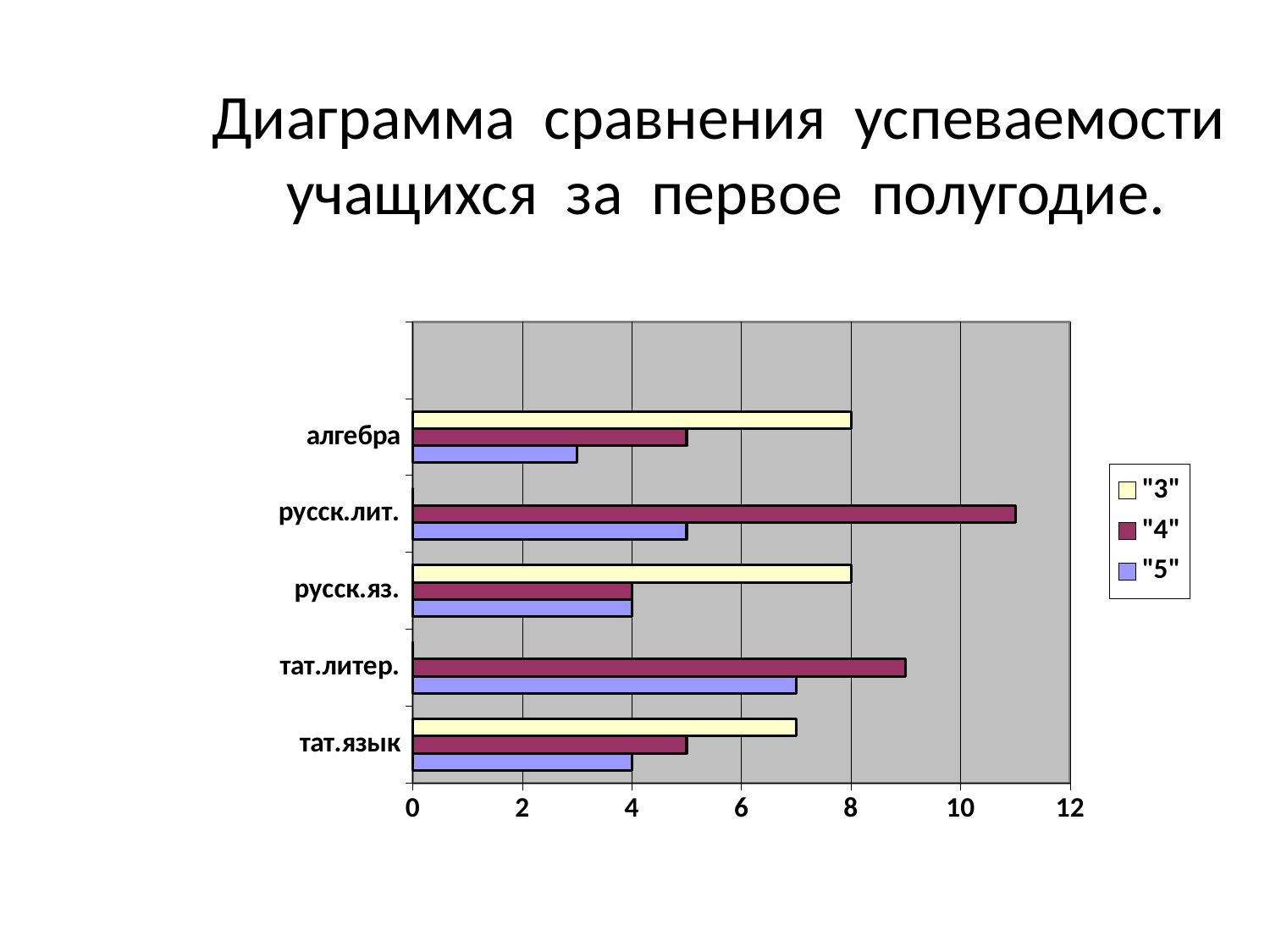
What is the value of the "5" series for тат.язык? 4 What is the value of the "3" series for алгебра? 8 Which is larger: the "5" series value for тат.литер. or for русск.лит.? тат.литер. How many subject categories are shown on the chart? 5 What kind of chart is shown on the slide? bar chart Is the value of the "4" series for тат.литер. greater or less than 8? greater Is the value of the "5" series for алгебра greater or less than 4? less Is the value of the "4" series for русск.лит. greater or less than 10? greater How many series does the legend list? 3 What is the value of the "4" series for русск.яз.? 4 Which subject has the lowest value for the "5" series? алгебра Which subject has the highest value for the "4" series? русск.лит.